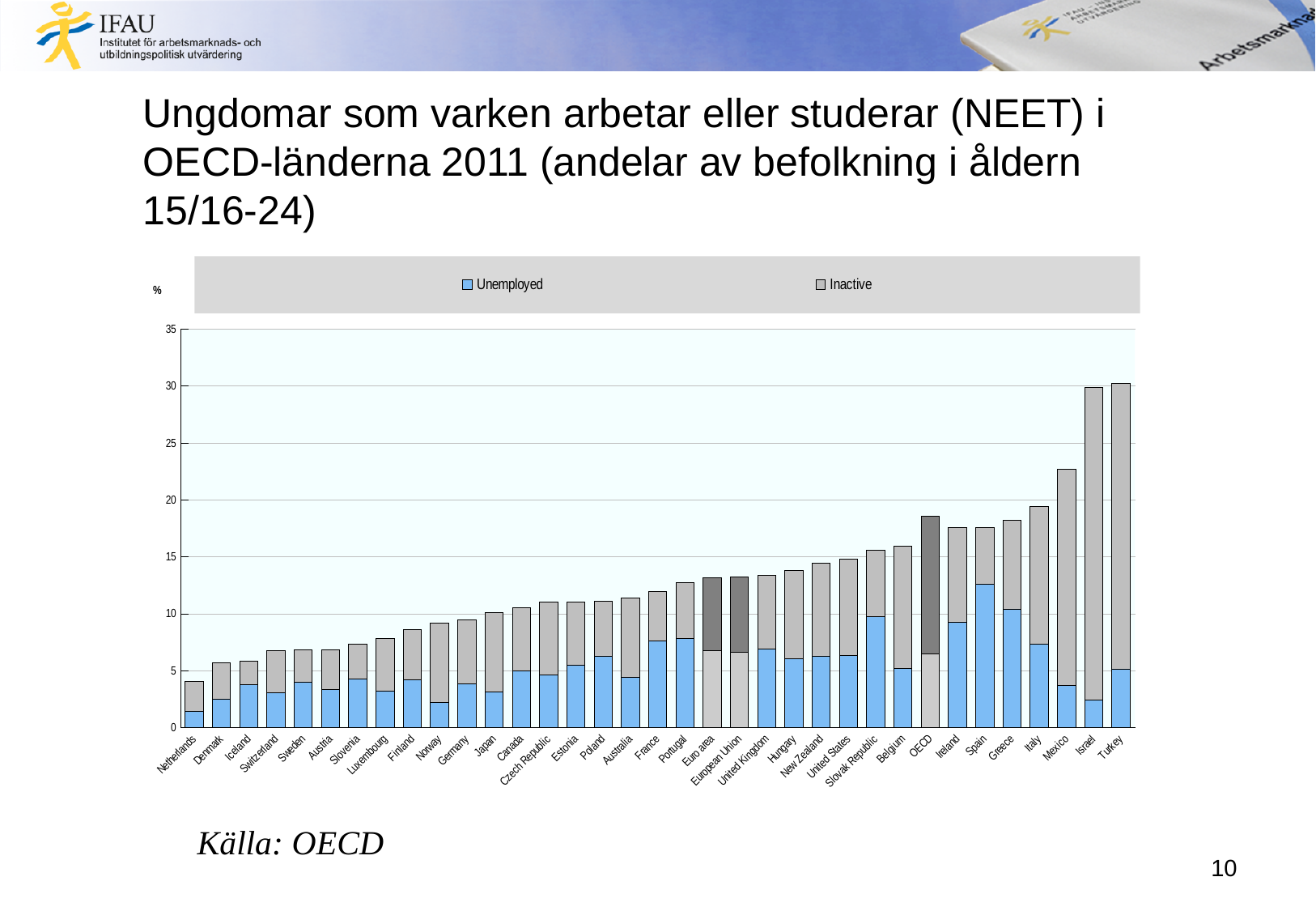
What kind of chart is shown on the slide? Stacked bar chart Is the Unemployed value for Spain greater or less than 10? greater Which has the larger total NEET share, Turkey or Mexico? Turkey Is the total value for Mexico greater or less than 20? greater What are the two series named in the legend? Unemployed and Inactive Is the total value for Netherlands greater or less than 5? less Do the total bar heights rise or fall from left to right along the x axis? Rise Which country has the lowest total NEET share? Netherlands Which country has the highest total NEET share? Turkey Which country has the largest Unemployed share? Spain How many series does the legend list? 2 How many countries or areas are shown along the x axis? 35